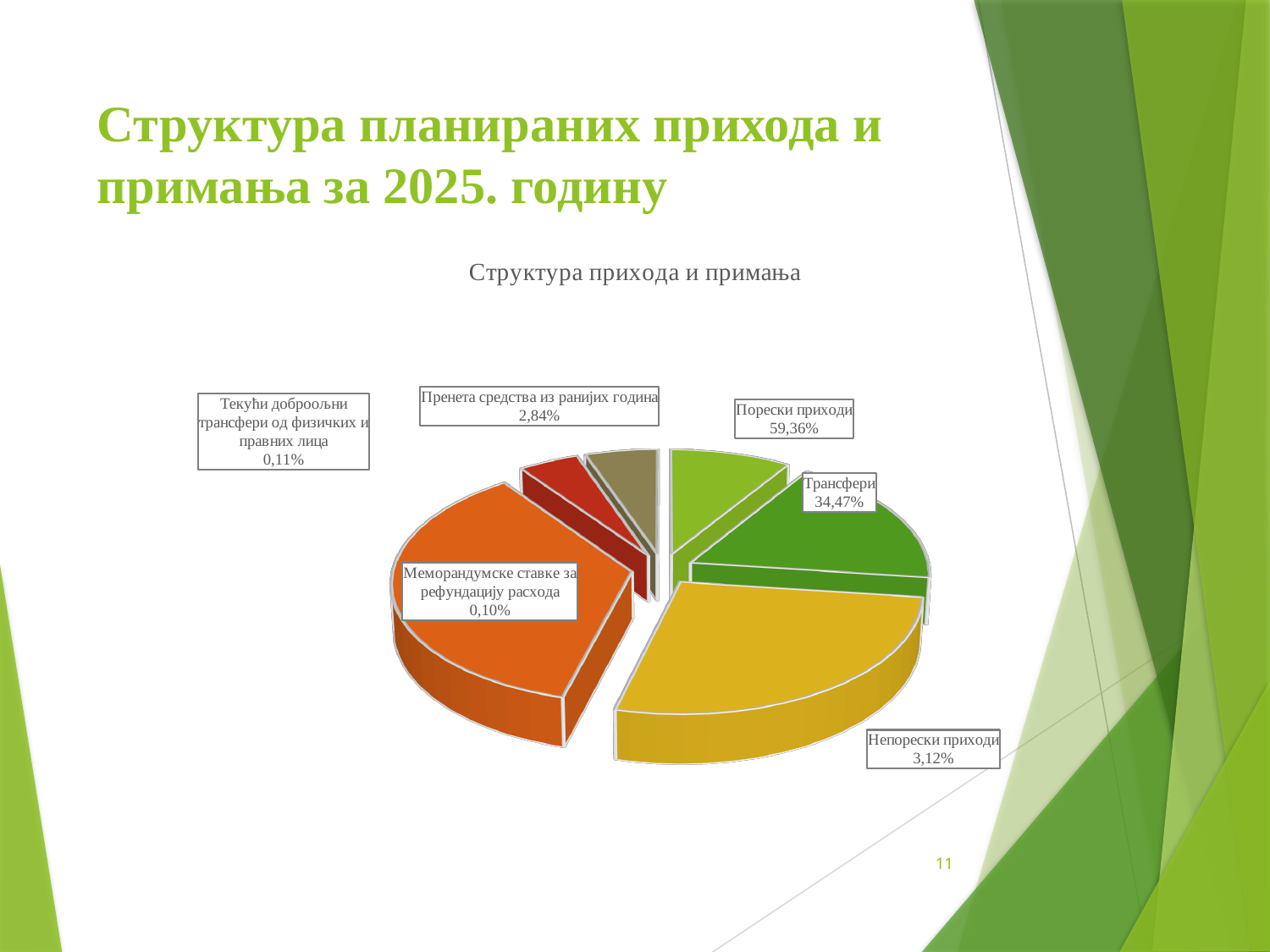
What share does Непорески приходи have in the pie chart? 3,12% What kind of chart is shown on the slide? Pie chart Which category has the smallest labelled share in the pie chart? Меморандумске ставке за рефундацију расхода What share does Трансфери have in the pie chart? 34,47% What share does Меморандумске ставке за рефундацију расхода have in the pie chart? 0,10% Which has a larger share, Непорески приходи or Пренета средства из ранијих година? Непорески приходи Which category has the largest labelled share in the pie chart? Порески приходи What share does Порески приходи have in the pie chart? 59,36% How many categories are shown in the pie chart? 6 What is the difference between the shares of Порески приходи and Трансфери? 24,89% What share does Пренета средства из ранијих година have in the pie chart? 2,84% What is the title of the chart? Структура прихода и примања